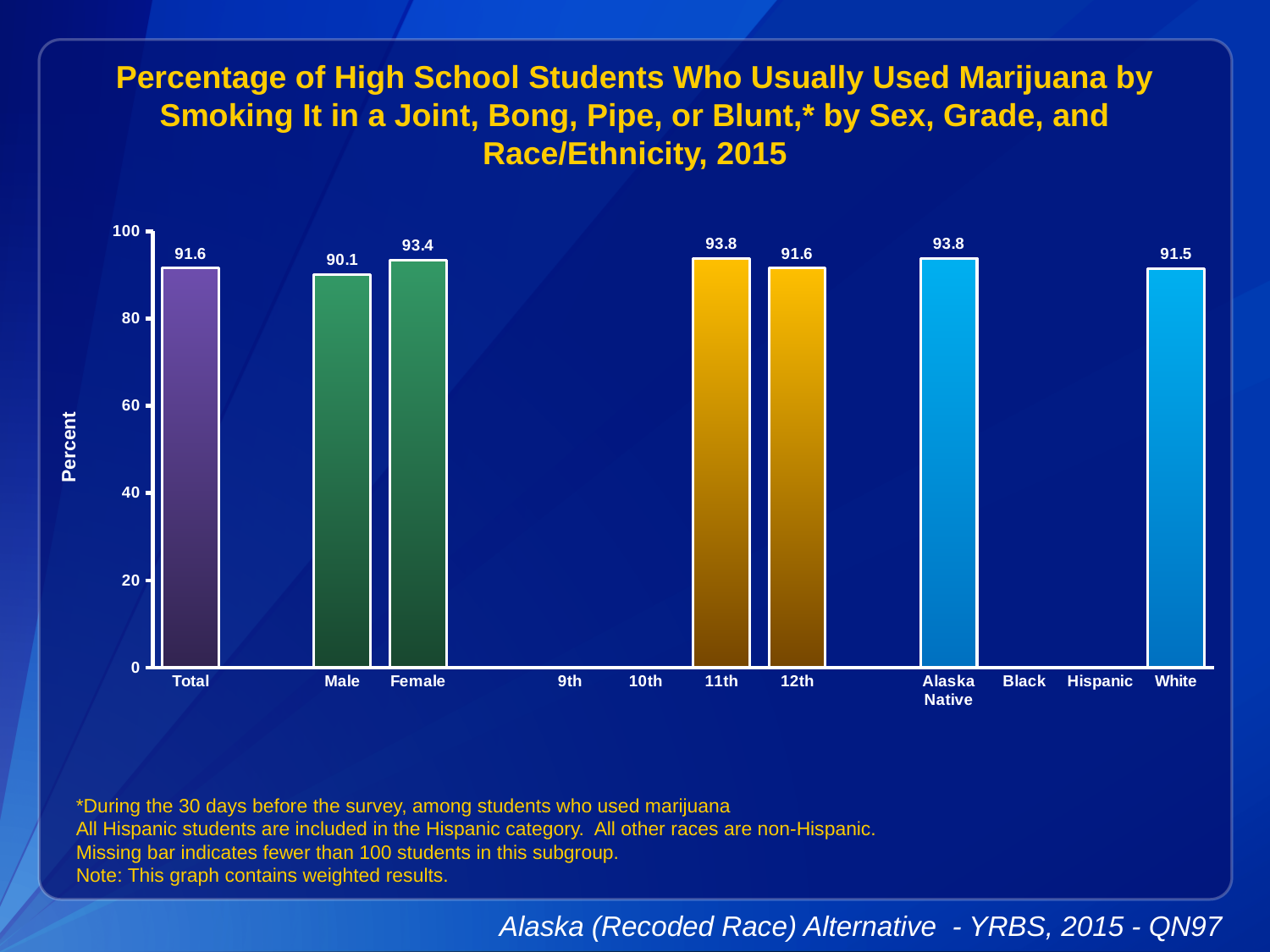
What is the value for 11th grade? 93.8 Which is larger, the value for 11th grade or the value for 12th grade? 11th What kind of chart is shown on the slide? bar chart Which category has the lowest value among the bars shown? Male What is the value for White? 91.5 How many categories on the x axis have no bar shown? 4 What is the value for Total? 91.6 What is the value for Female? 93.4 What is the difference between the Female and Male values? 3.3 What is the difference between the 12th grade value and the White value? 0.1 Is the value for Alaska Native greater or less than 80? greater What is the label on the y axis? Percent